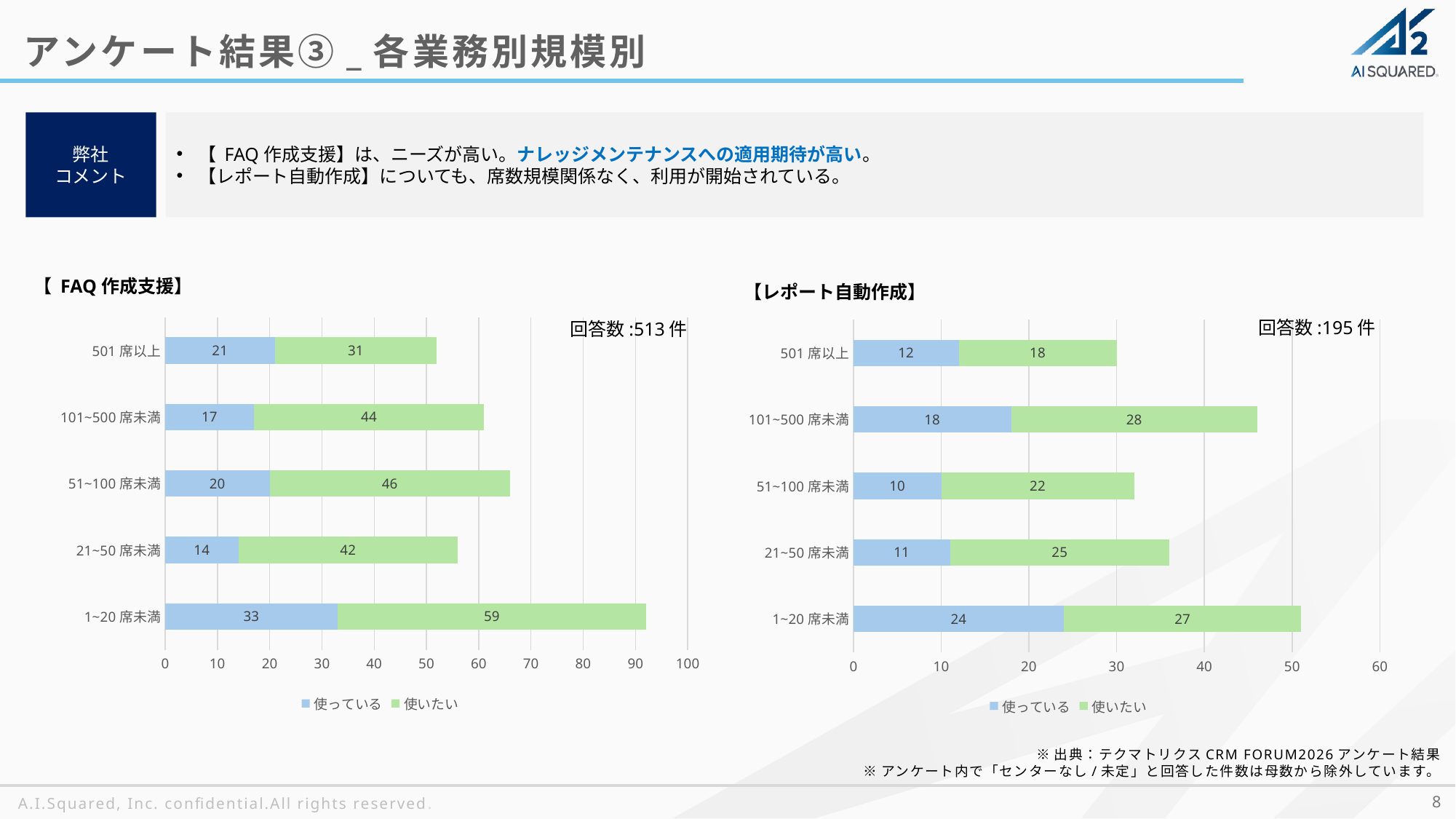
In the 【レポート自動作成】 chart, which category has the lowest 使っている value? 51~100席未満 In the 【レポート自動作成】 chart, which is larger: 使っている for 1~20席未満 or 使っている for 101~500席未満? 1~20席未満 In the 【レポート自動作成】 chart, what is the value of 使っている for 501席以上? 12 In the 【レポート自動作成】 chart, what is the value of 使いたい for 101~500席未満? 28 In the 【FAQ作成支援】 chart, what is the difference between the 使いたい values for 101~500席未満 and 501席以上? 13 In the 【FAQ作成支援】 chart, what is the total of the stacked bar for 1~20席未満? 92 What type of chart is the 【レポート自動作成】 chart? Stacked bar chart In the 【レポート自動作成】 chart, what is the total of the stacked bar for 101~500席未満? 46 In the 【FAQ作成支援】 chart, what is the value of 使いたい for 51~100席未満? 46 How many categories are shown in the 【FAQ作成支援】 chart? 5 In the 【FAQ作成支援】 chart, which category has the highest 使いたい value? 1~20席未満 In the 【FAQ作成支援】 chart, what is the value of 使っている for 1~20席未満? 33